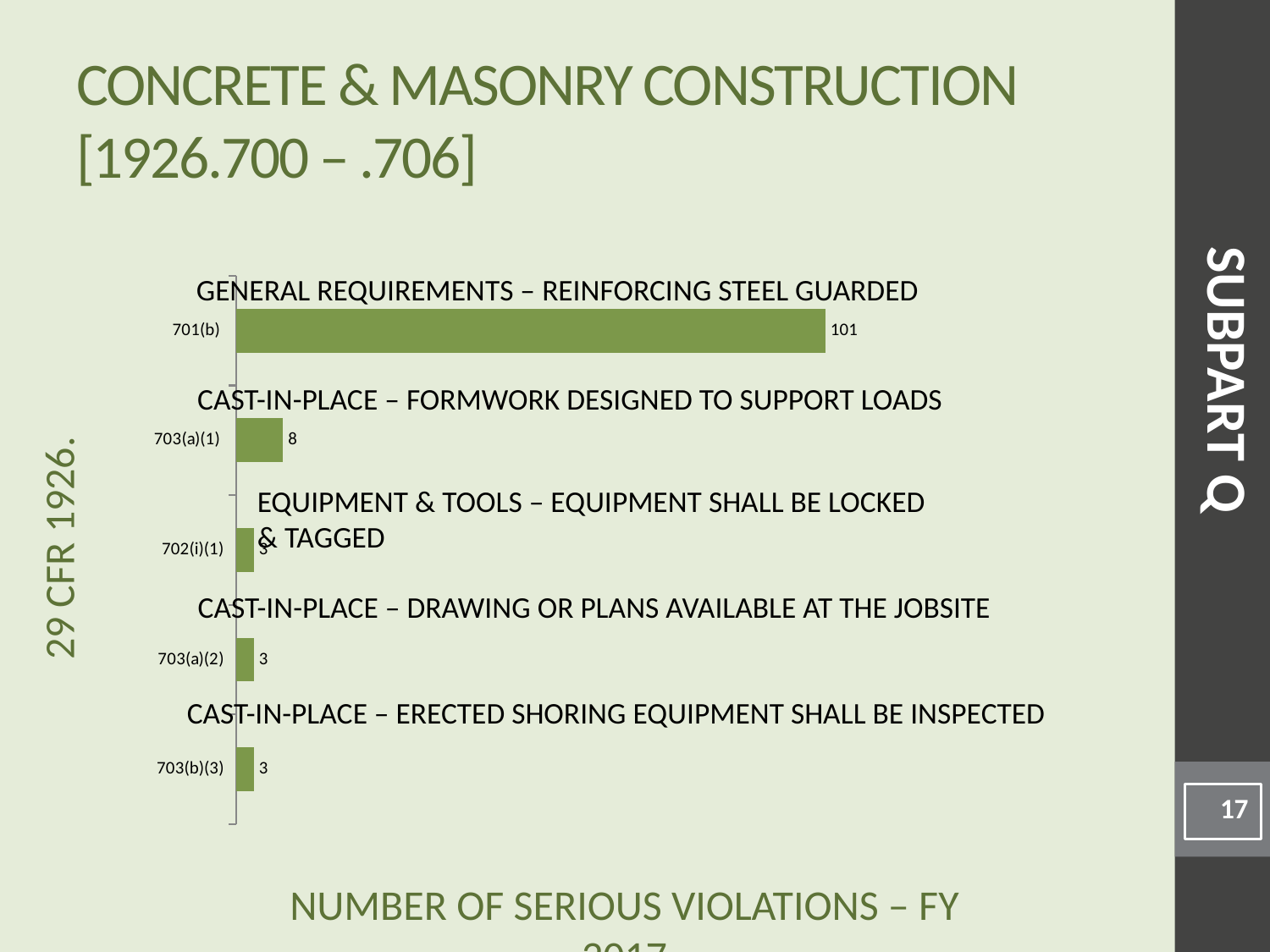
What is the number of serious violations for 703(a)(1)? 8 What is the difference between the number of serious violations for 703(a)(1) and 703(a)(2)? 5 Which standard has the highest number of serious violations? 701(b) What type of chart is shown on the slide? Bar chart What is the number of serious violations for 703(a)(2)? 3 How many standards (categories) are shown in the chart? 5 What is the number of serious violations for 701(b)? 101 What is the difference between the number of serious violations for 701(b) and 703(a)(1)? 93 Which has more serious violations, 703(a)(1) or 703(b)(3)? 703(a)(1) What is the number of serious violations for 703(b)(3)? 3 Which standard is described as 'GENERAL REQUIREMENTS – REINFORCING STEEL GUARDED'? 701(b)